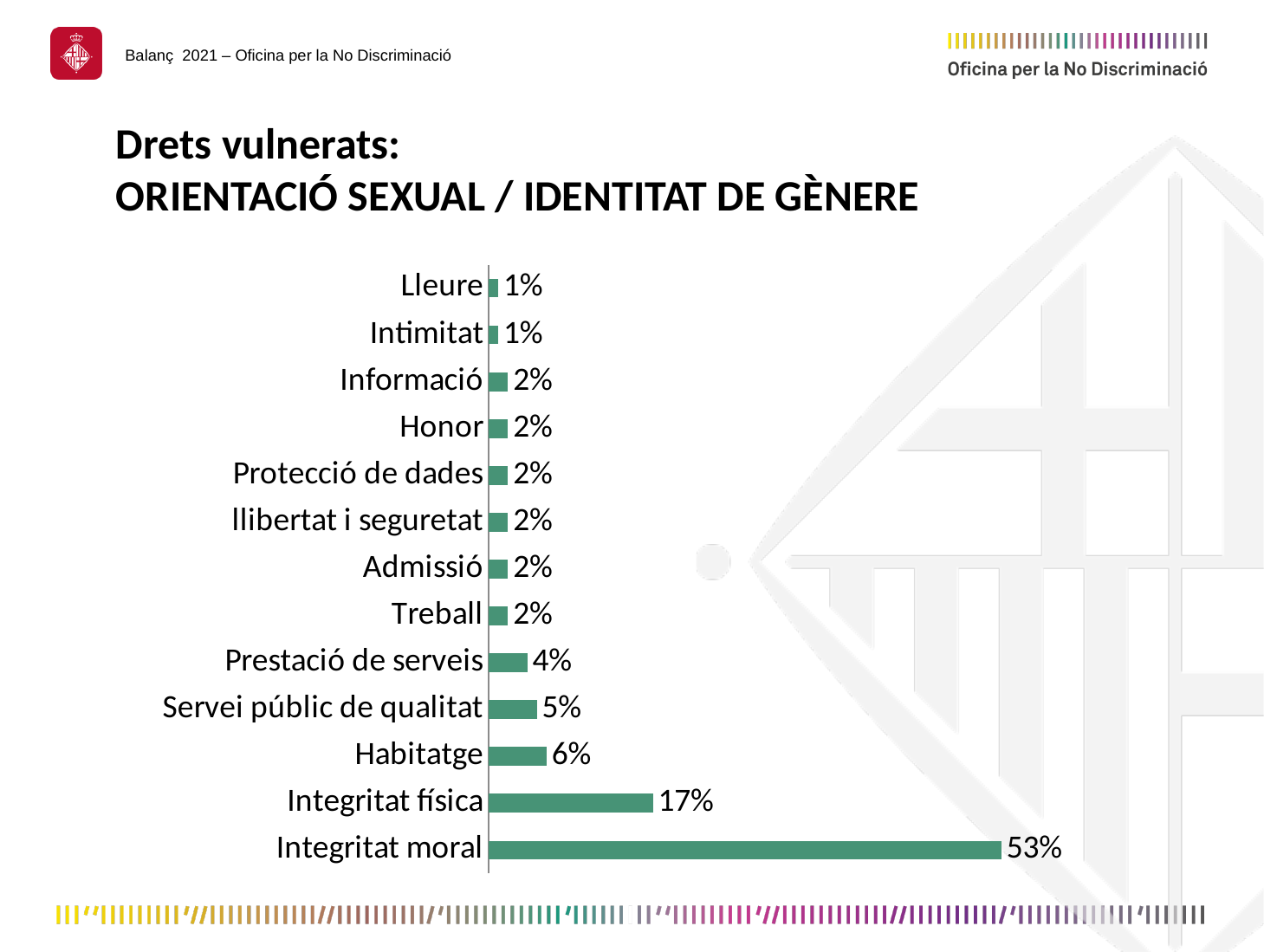
What is the difference between Habitatge and Prestació de serveis? 2% What is the difference between Integritat moral and Integritat física? 36% What is the value for Lleure? 1% What kind of chart is shown on the slide? Bar chart What is the value for Habitatge? 6% What is the value for Prestació de serveis? 4% Which is larger, Integritat física or Habitatge? Integritat física Which category has the highest value? Integritat moral How many categories are shown in the chart? 13 What is the value for Servei públic de qualitat? 5% What is the value for Integritat moral? 53% What is the value for Integritat física? 17%